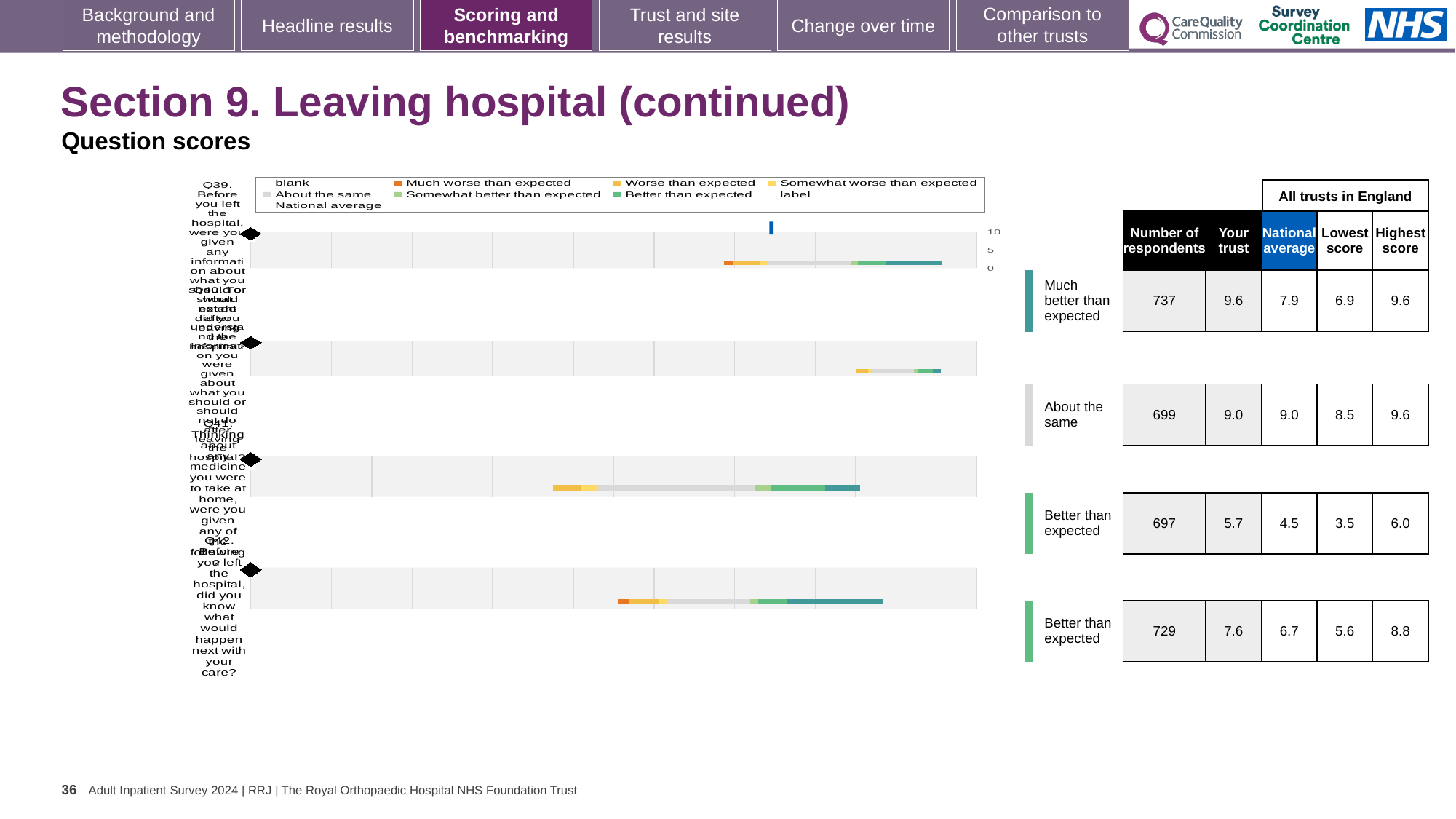
In the table beside the chart, what is the 'Highest score' value in the last row? 8.8 In the table beside the chart, which row has the highest number of respondents? the first row (Much better than expected), 737 How many survey questions (rows) are plotted in the chart? 4 In the table beside the chart, what is the number of respondents for the first row (Much better than expected)? 737 In the table beside the chart, which row has the lowest 'Your trust' score? the third row, 5.7 In the table beside the chart, for the first row, which is larger: the 'Your trust' score or the 'National average'? Your trust In the chart legend, what colour represents 'Much worse than expected'? orange In the table beside the chart, what is the difference between the 'Your trust' score and the 'National average' in the first row? 1.7 In the table beside the chart, what is the 'Your trust' score for the row labelled 'About the same'? 9.0 In the chart legend, what colour represents 'Better than expected'? green What kind of chart is shown on the slide? bar chart In the table beside the chart, what is the 'Lowest score' value in the third row? 3.5